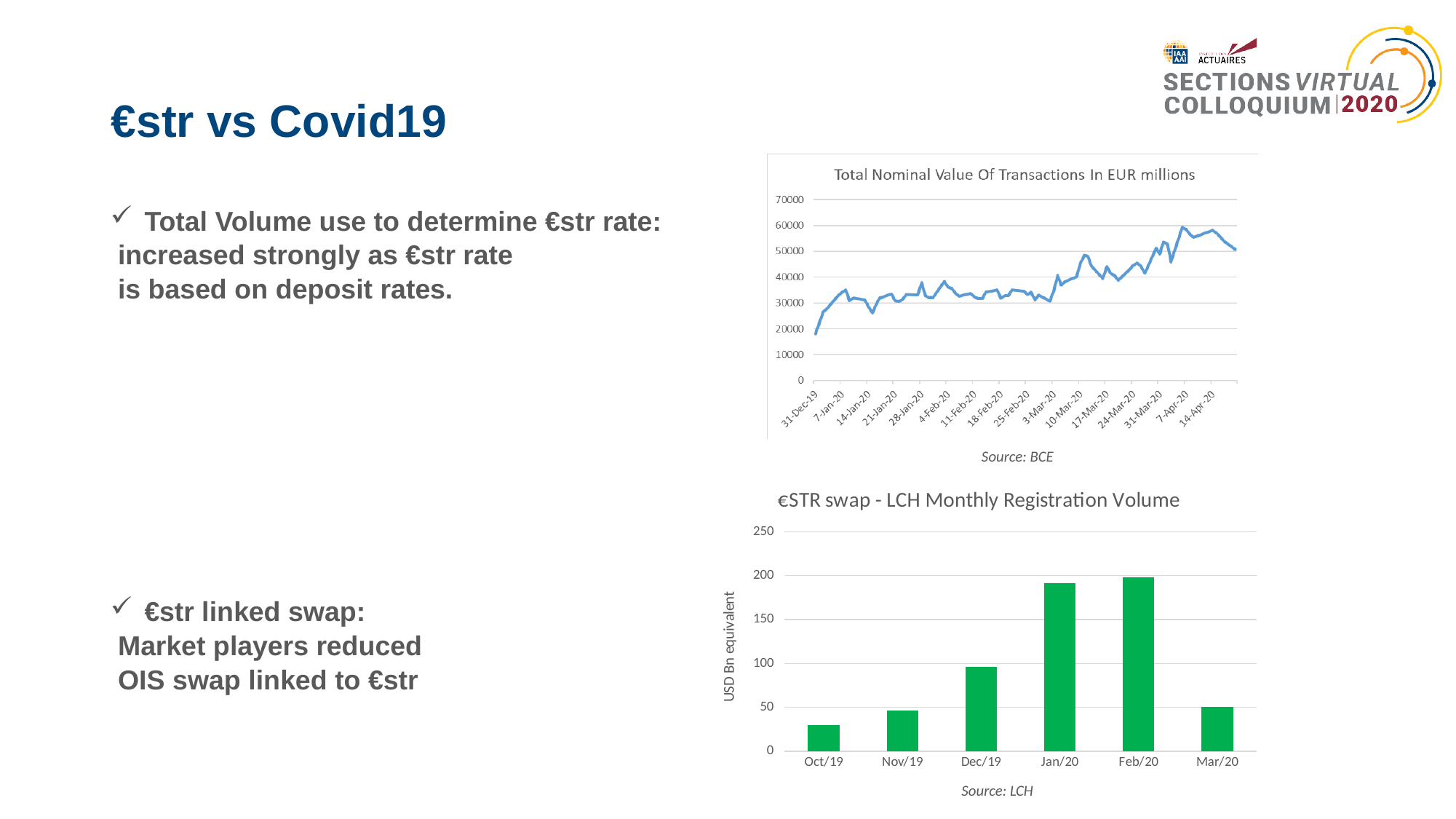
In the '€STR swap - LCH Monthly Registration Volume' chart, is the value for Oct/19 greater or less than 50? less In the 'Total Nominal Value Of Transactions In EUR millions' chart, is the value at 31-Dec-19 greater or less than 20000? less What kind of chart is the 'Total Nominal Value Of Transactions In EUR millions' chart? line chart In the '€STR swap - LCH Monthly Registration Volume' chart, which is larger, Dec/19 or Mar/20? Dec/19 In the '€STR swap - LCH Monthly Registration Volume' chart, which month has the lowest volume? Oct/19 What source is cited below the 'Total Nominal Value Of Transactions In EUR millions' chart? BCE What kind of chart is the '€STR swap - LCH Monthly Registration Volume' chart? bar chart In the '€STR swap - LCH Monthly Registration Volume' chart, is the value for Jan/20 greater or less than 150? greater In the 'Total Nominal Value Of Transactions In EUR millions' chart, do the values generally rise or fall from 31-Dec-19 to April 2020? rise How many months are shown in the '€STR swap - LCH Monthly Registration Volume' chart? 6 What is the y-axis label of the '€STR swap - LCH Monthly Registration Volume' chart? USD Bn equivalent